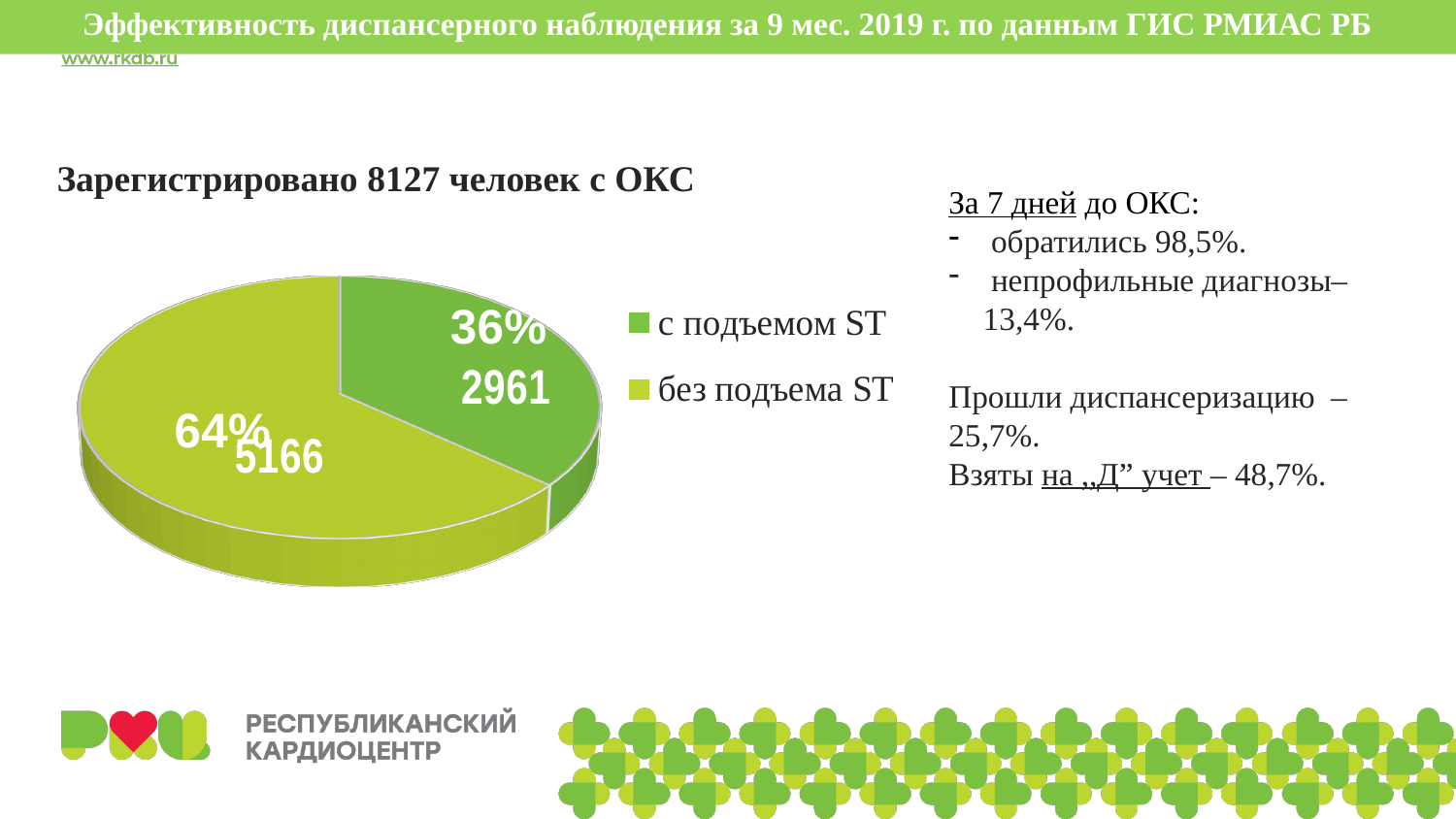
What is the number of patients shown for the slice "без подъема ST"? 5166 Which slice of the pie chart is the largest? без подъема ST How many slices does the pie chart have? 2 What share of the pie does the slice "с подъемом ST" represent? 36% Which is larger: the value for "с подъемом ST" or the value for "без подъема ST"? без подъема ST Which slice of the pie chart is the smallest? с подъемом ST What share of the pie does the slice "без подъема ST" represent? 64% How many entries does the legend of the pie chart list? 2 What is the number of patients shown for the slice "с подъемом ST"? 2961 What is the difference between the number of patients without ST elevation (без подъема ST) and with ST elevation (с подъемом ST)? 2205 What is the total number of patients represented by the two slices of the pie chart? 8127 What kind of chart is shown on the slide? pie chart